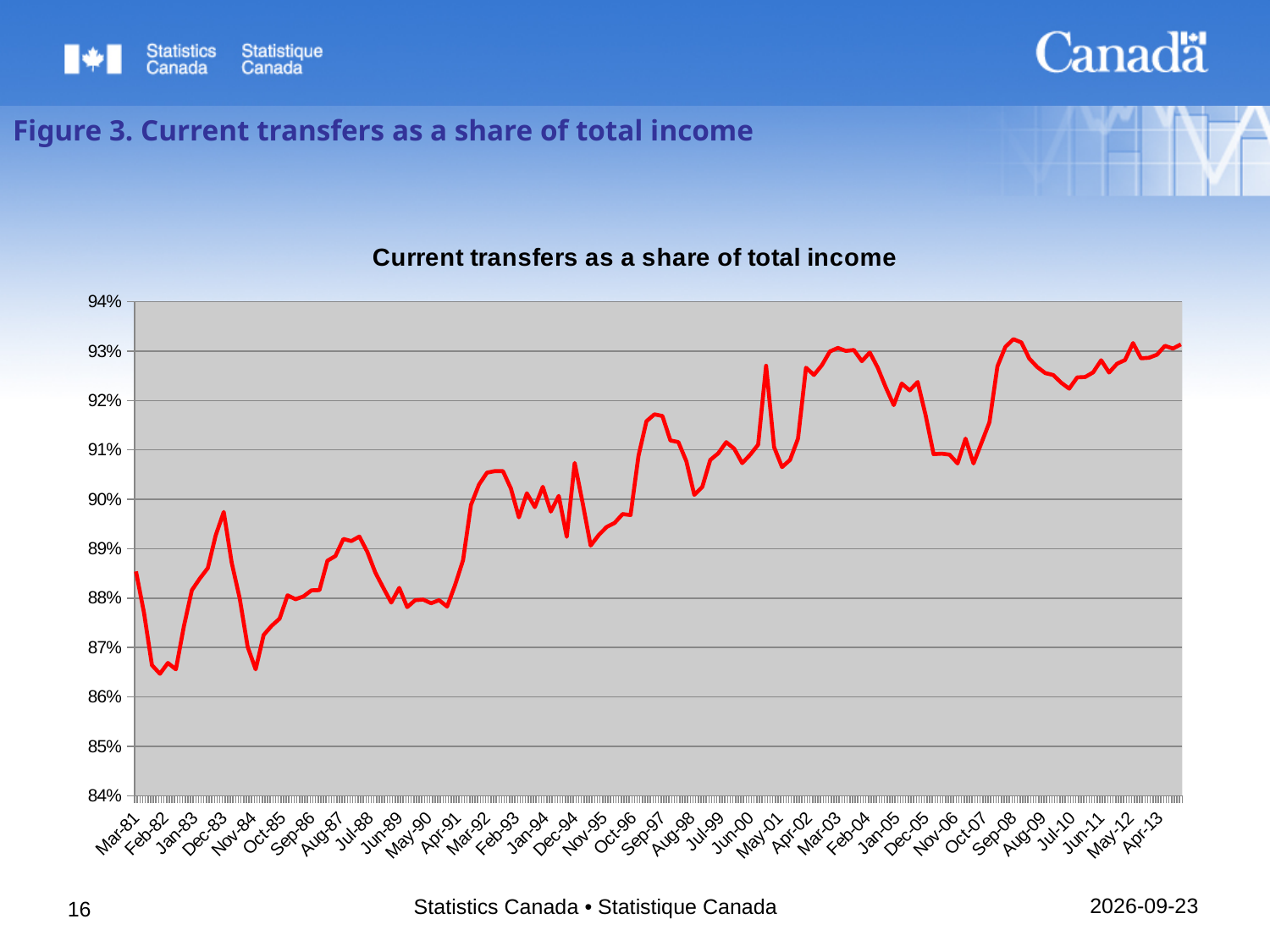
Is the value for Apr-13 greater or less than 92%? greater Is the value for Mar-81 greater or less than 88%? greater Is the value for Dec-83 greater or less than 89%? greater What kind of chart is shown on the slide? line chart Which is larger, the value for Feb-82 or the value for Dec-83? Dec-83 Which is larger, the value for Mar-81 or the value for Apr-13? Apr-13 Overall, do the values rise or fall from Mar-81 to Apr-13? rise What is the title of the chart? Current transfers as a share of total income